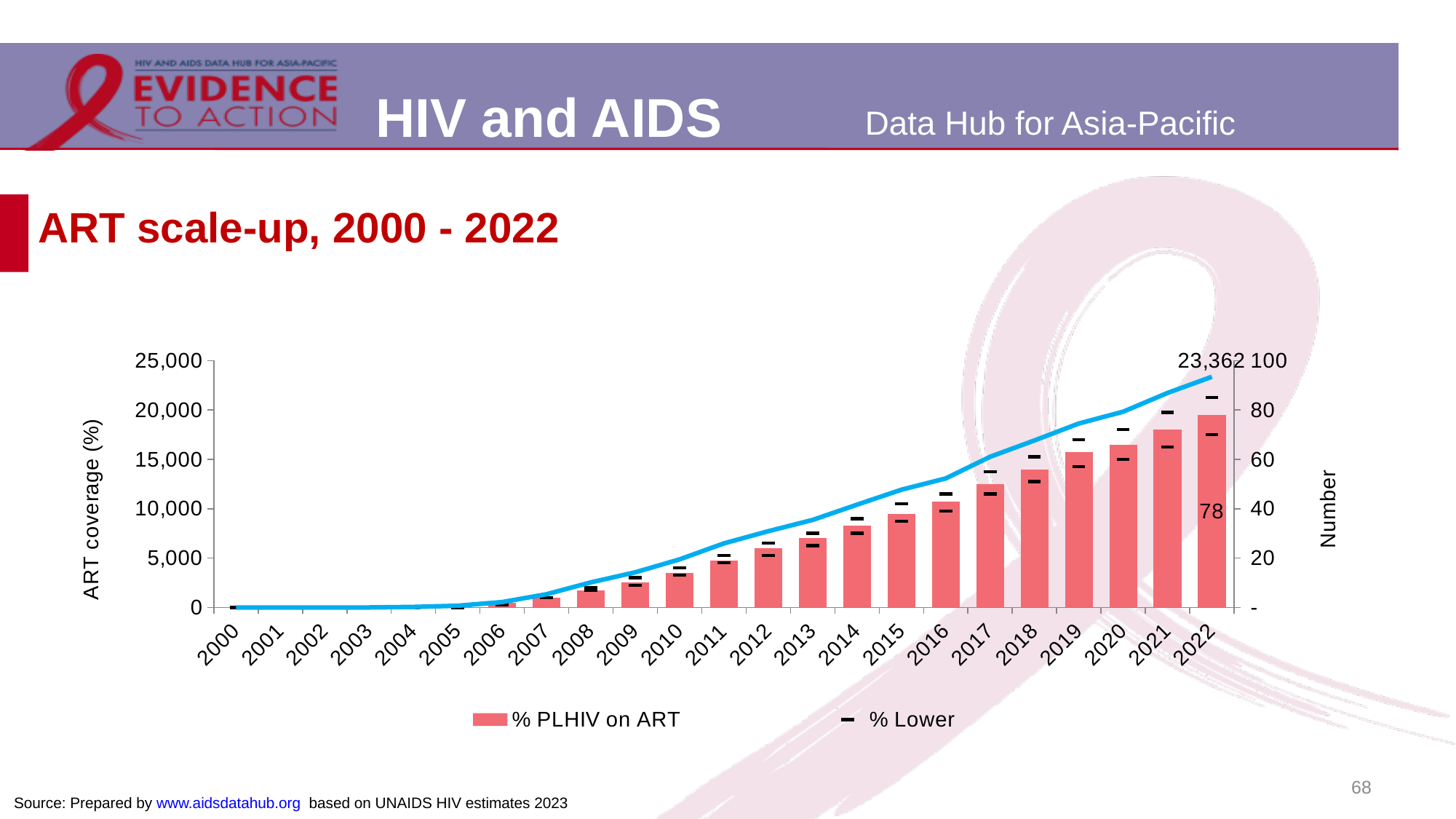
How many series does the legend list? 2 What value is labelled at the end of the line in 2022? 23,362 What kind of chart is shown on the slide? bar and line chart How many years are shown on the x axis? 23 Is the bar value for 2010 greater or less than 20? less What is the title of the chart on the slide? ART scale-up, 2000 - 2022 Which year has the tallest bar? 2022 Is the line value for 2016 greater or less than 10,000? greater What is the data label shown on the bar for 2022? 78 Do the bar values generally rise or fall from 2000 to 2022? rise Which year has the taller bar, 2014 or 2018? 2018 Is the bar value for 2017 greater or less than 40? greater